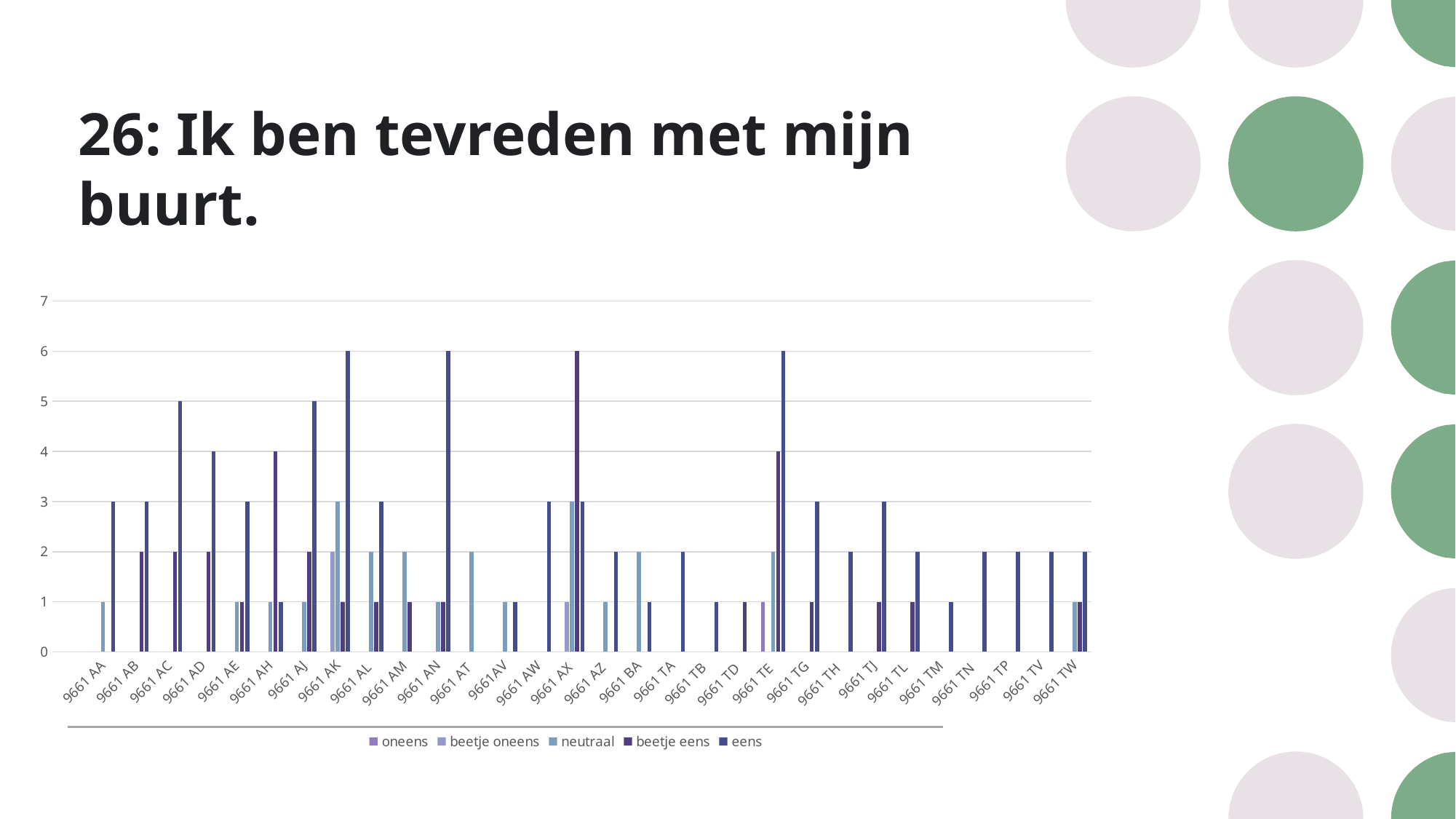
What is the value of 'eens' for 9661 AD? 4 Is the 'eens' value for 9661 AK greater or less than 5? greater What is the value of 'neutraal' for 9661 AK? 3 What is the value of 'beetje eens' for 9661 AX? 6 How many series does the legend list? 5 What is the first entry in the legend? oneens What is the difference between the 'eens' value for 9661 AC and for 9661 AB? 2 Which is larger, the 'eens' value for 9661 AC or for 9661 AB? 9661 AC What kind of chart is shown on the slide? bar chart What is the title of the slide? 26: Ik ben tevreden met mijn buurt. What is the value of 'eens' for 9661 AC? 5 How many categories are shown on the x axis? 30